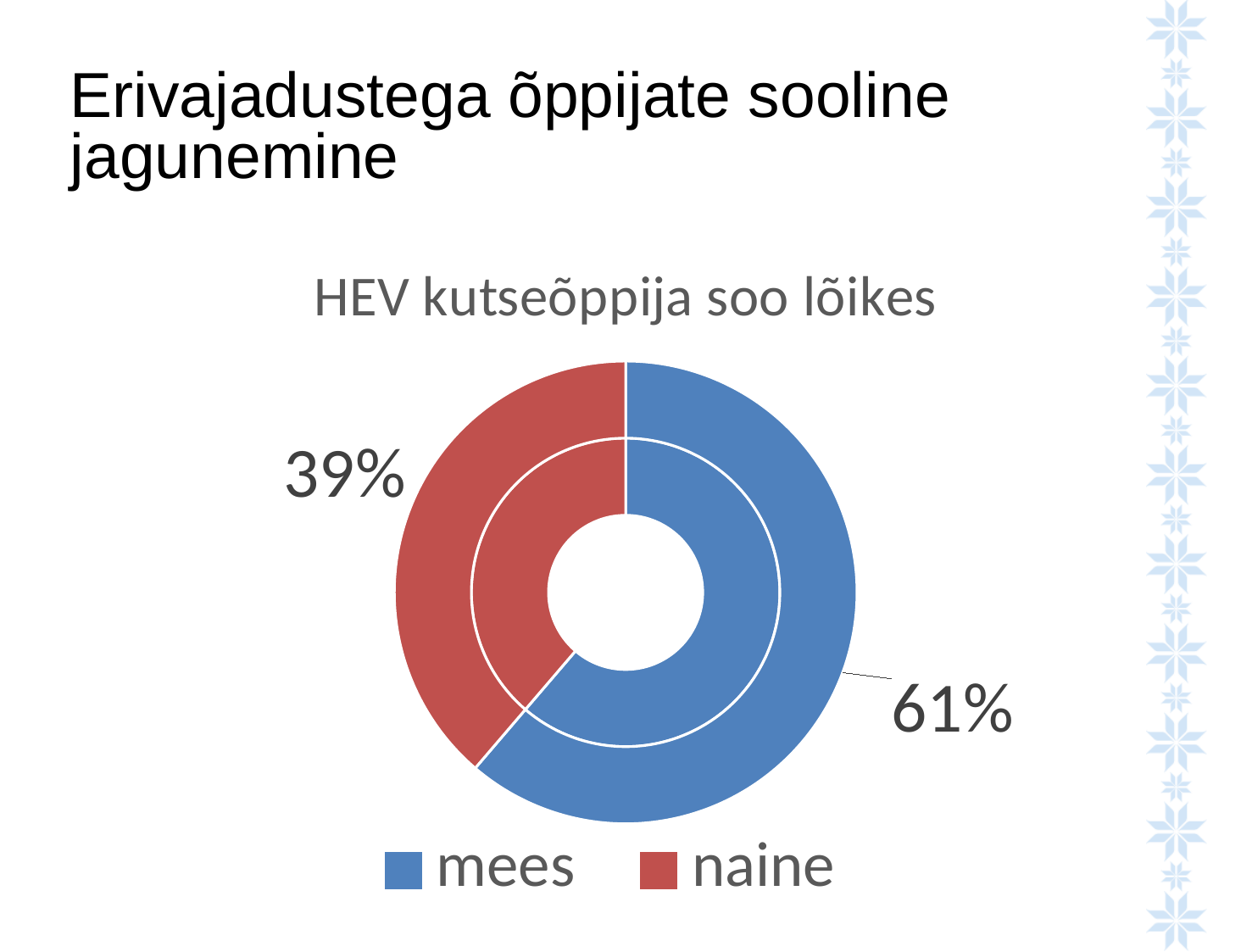
What colour represents naine in the chart? red What is the difference in percentage points between the mees and naine shares? 22 What share of the chart is labelled for mees? 61% Which category has the largest share in the chart? mees What is the title of the chart? HEV kutseõppija soo lõikes Which is larger, the share for mees or the share for naine? mees Which category has the smallest share in the chart? naine What share of the chart is labelled for naine? 39% Is the share for mees greater or less than 50%? greater What type of chart is shown on the slide? doughnut chart How many categories does the legend list? 2 Is the share for naine greater or less than 50%? less